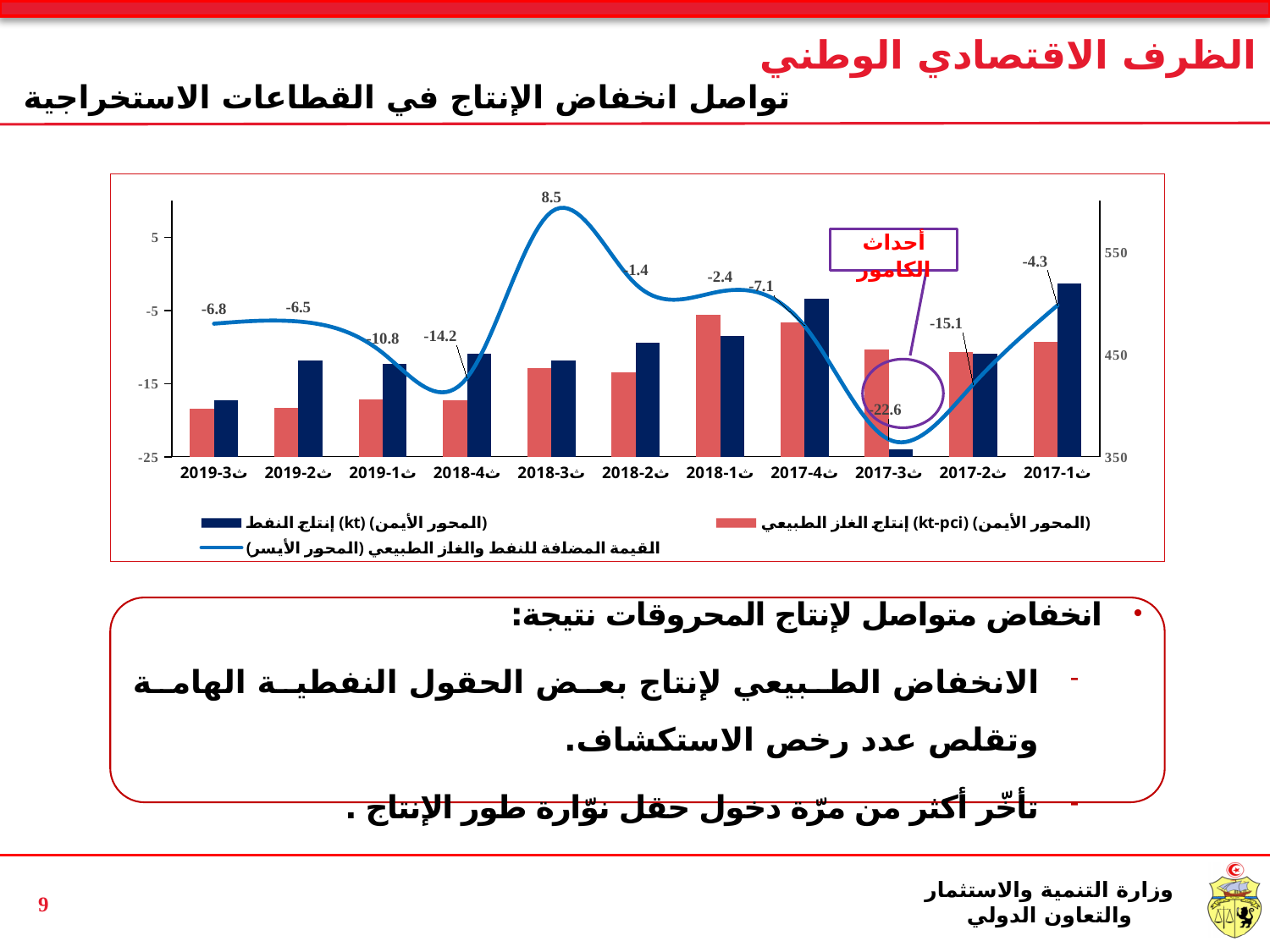
How many series does the chart legend list? 3 In which quarter does the value-added line reach its highest value? ث3-2018 Is the oil production bar (إنتاج النفط) for ث4-2017 greater or less than 450 on the right axis? greater What kind of chart is shown on the slide? Combined bar and line chart Is the oil production bar (إنتاج النفط) for ث3-2017 greater or less than 450 on the right axis? less What value does the value-added line show for ث1-2017? -4.3 Which quarter has a higher value on the value-added line, ث2-2017 or ث4-2017? ث4-2017 What value does the value-added line show for ث3-2017? -22.6 How many quarters are shown on the x axis of the chart? 11 What value does the value-added line (القيمة المضافة للنفط والغاز الطبيعي) show for ث3-2018? 8.5 In which quarter does the value-added line reach its lowest value? ث3-2017